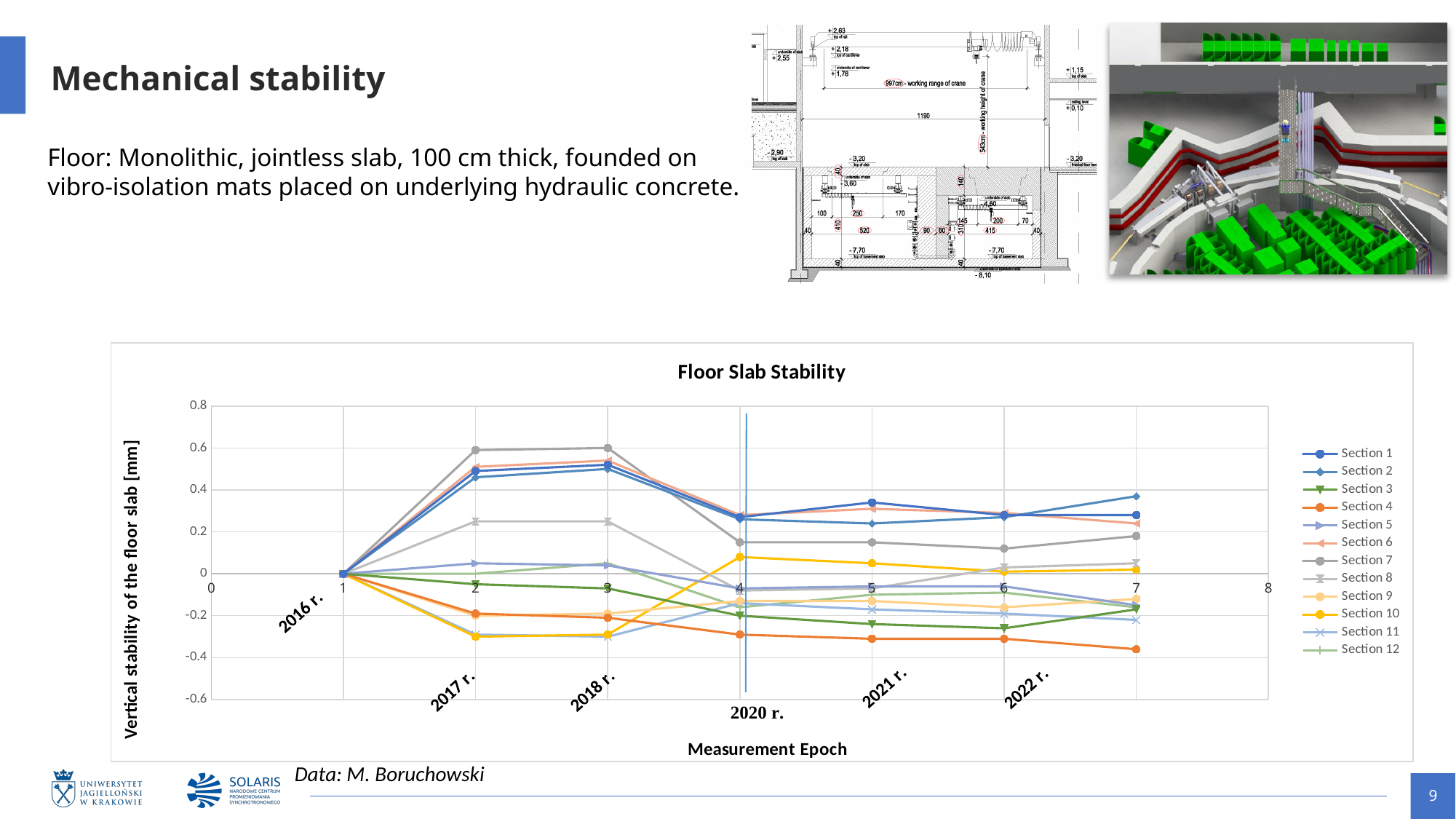
How many series does the legend of the Floor Slab Stability chart list? 12 At measurement epoch 2, which is larger: the value for Section 7 or the value for Section 4? Section 7 Is the value for Section 7 at measurement epoch 2 greater or less than 0.4? greater Is the value for Section 4 at measurement epoch 7 greater or less than -0.2? less Which section has the lowest value at measurement epoch 7? Section 4 What is the label of the vertical axis of the chart? Vertical stability of the floor slab [mm] What is the value of Section 1 at measurement epoch 1? 0 Does the value for Section 4 rise or fall from measurement epoch 1 to measurement epoch 7? fall What kind of chart is shown on the slide? line chart How many measurement epochs have plotted data points in the chart? 7 Which section has the highest value at measurement epoch 2? Section 7 What is the title of the chart on the slide? Floor Slab Stability